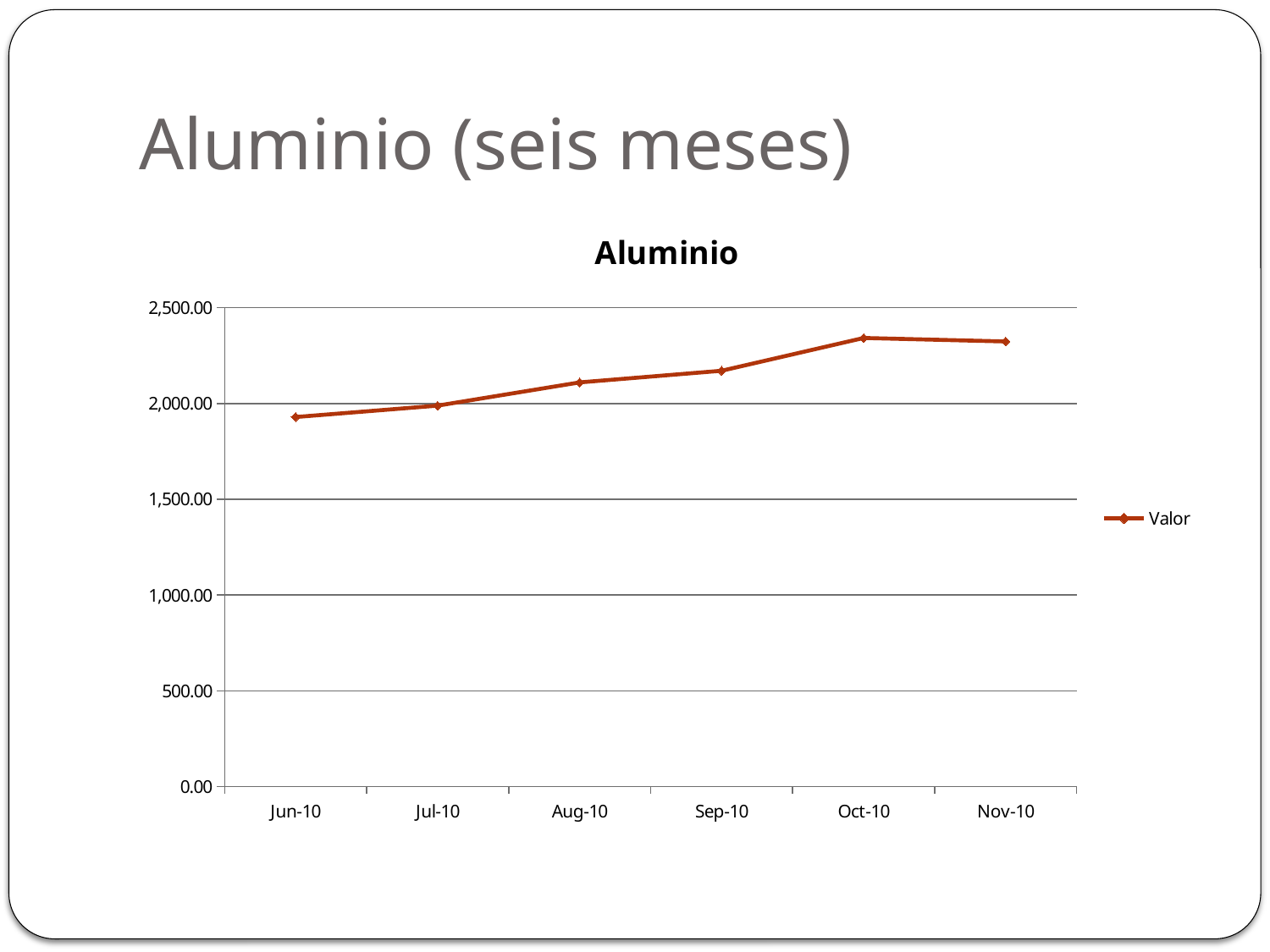
How many months are plotted on the x axis? 6 What kind of chart is shown on the slide? line chart Is the value for Aug-10 greater or less than 2,000.00? greater How many series does the legend list? 1 Is the value for Jun-10 greater or less than 2,000.00? less Is the value for Oct-10 greater or less than 2,500.00? less Which month has the lowest value? Jun-10 Do the values generally rise or fall from Jun-10 to Oct-10? rise Which is larger, the value for Oct-10 or the value for Jun-10? Oct-10 Which is larger, the value for Sep-10 or the value for Jul-10? Sep-10 What is the title of the chart? Aluminio What series name does the legend show? Valor